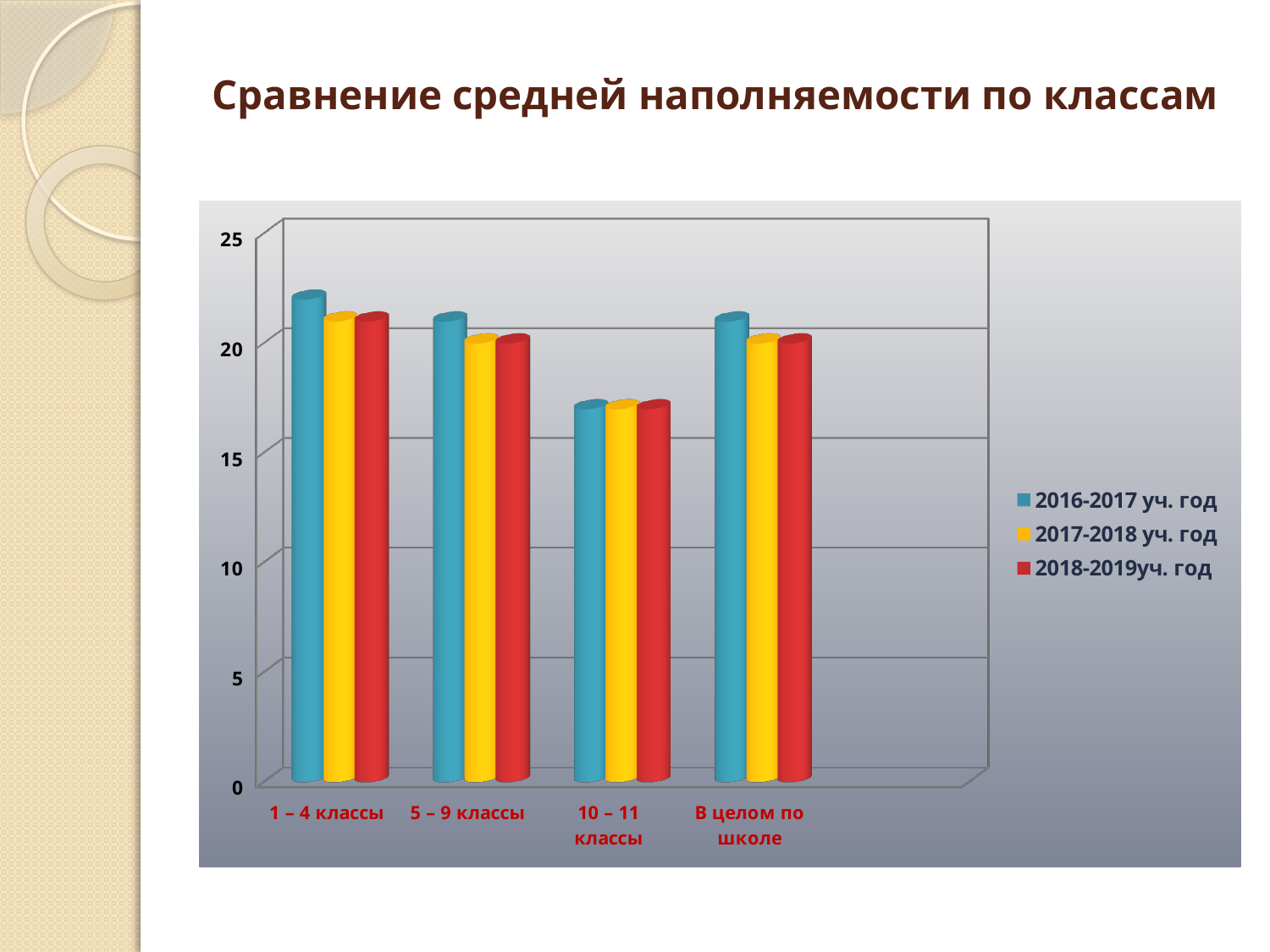
Is the value for 10 – 11 классы in the 2016-2017 уч. год series greater or less than 20? less What is the title of the slide above the chart? Сравнение средней наполняемости по классам How many series does the legend list? 3 Which category has the highest value in the 2016-2017 уч. год series? 1 – 4 классы Is the value for 10 – 11 классы in the 2018-2019уч. год series greater or less than 15? greater Which category has the lowest value in the 2016-2017 уч. год series? 10 – 11 классы How many categories are shown on the x axis of the chart? 4 What kind of chart is shown on the slide? bar chart In the 2017-2018 уч. год series, which is larger: the value for 1 – 4 классы or for 10 – 11 классы? 1 – 4 классы Is the value for 1 – 4 классы in the 2016-2017 уч. год series greater or less than 20? greater Which series is shown in red in the chart? 2018-2019уч. год